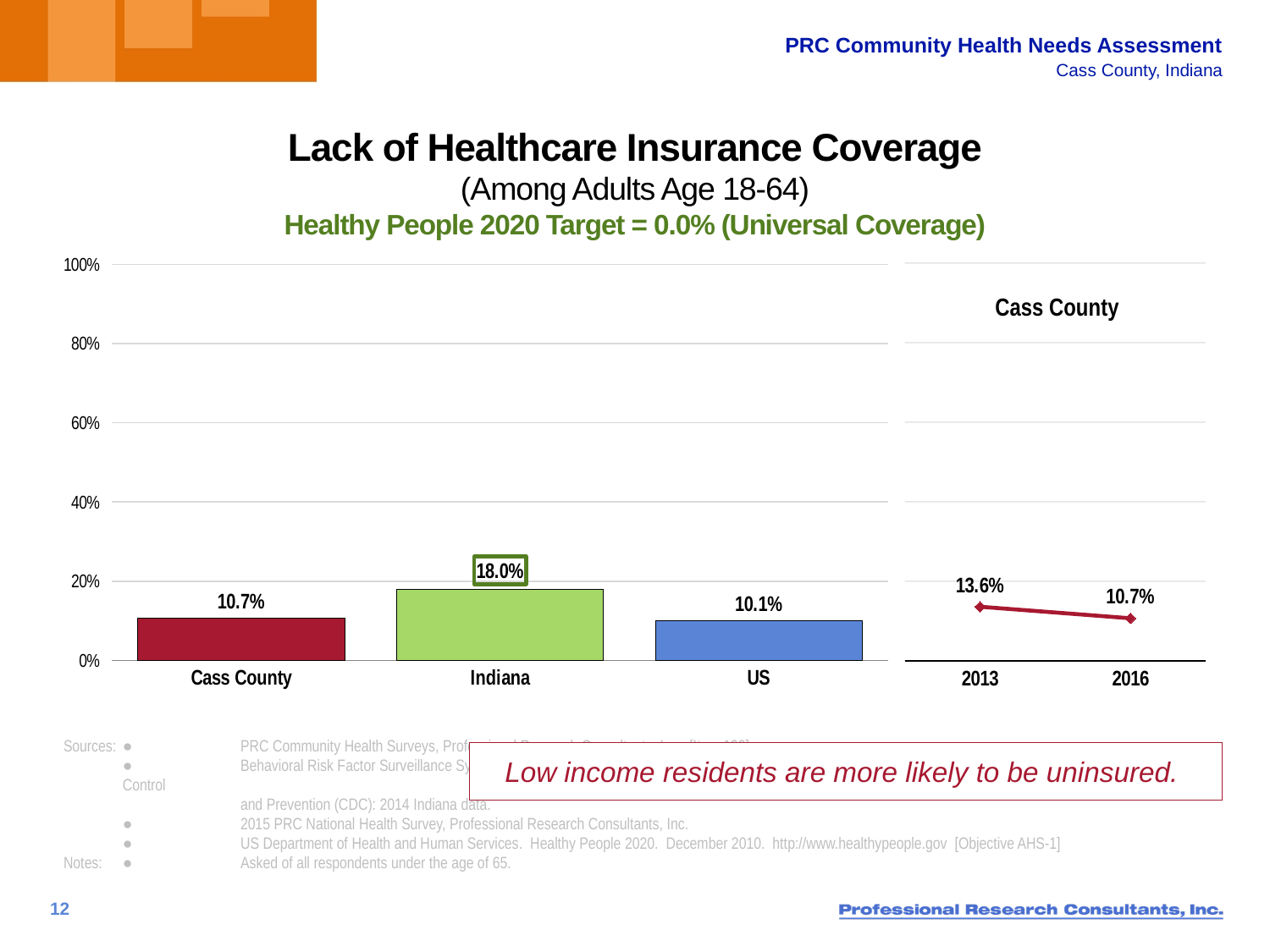
In the bar chart on the left, which category has the highest value? Indiana In the Cass County trend chart on the right, what is the value for 2013? 13.6% In the Cass County trend chart on the right, what is the value for 2016? 10.7% In the bar chart on the left, what is the value for Indiana? 18.0% In the bar chart on the left, what is the value for US? 10.1% In the bar chart on the left, what is the difference between the Indiana value and the US value? 7.9% In the bar chart on the left, how many categories are shown? 3 In the bar chart on the left, what is the value for Cass County? 10.7% In the bar chart on the left, which category has the lowest value? US What type of chart is the chart on the left? bar chart In the bar chart on the left, is the value for Indiana greater or less than 20%? less In the Cass County trend chart on the right, do the values rise or fall from 2013 to 2016? fall